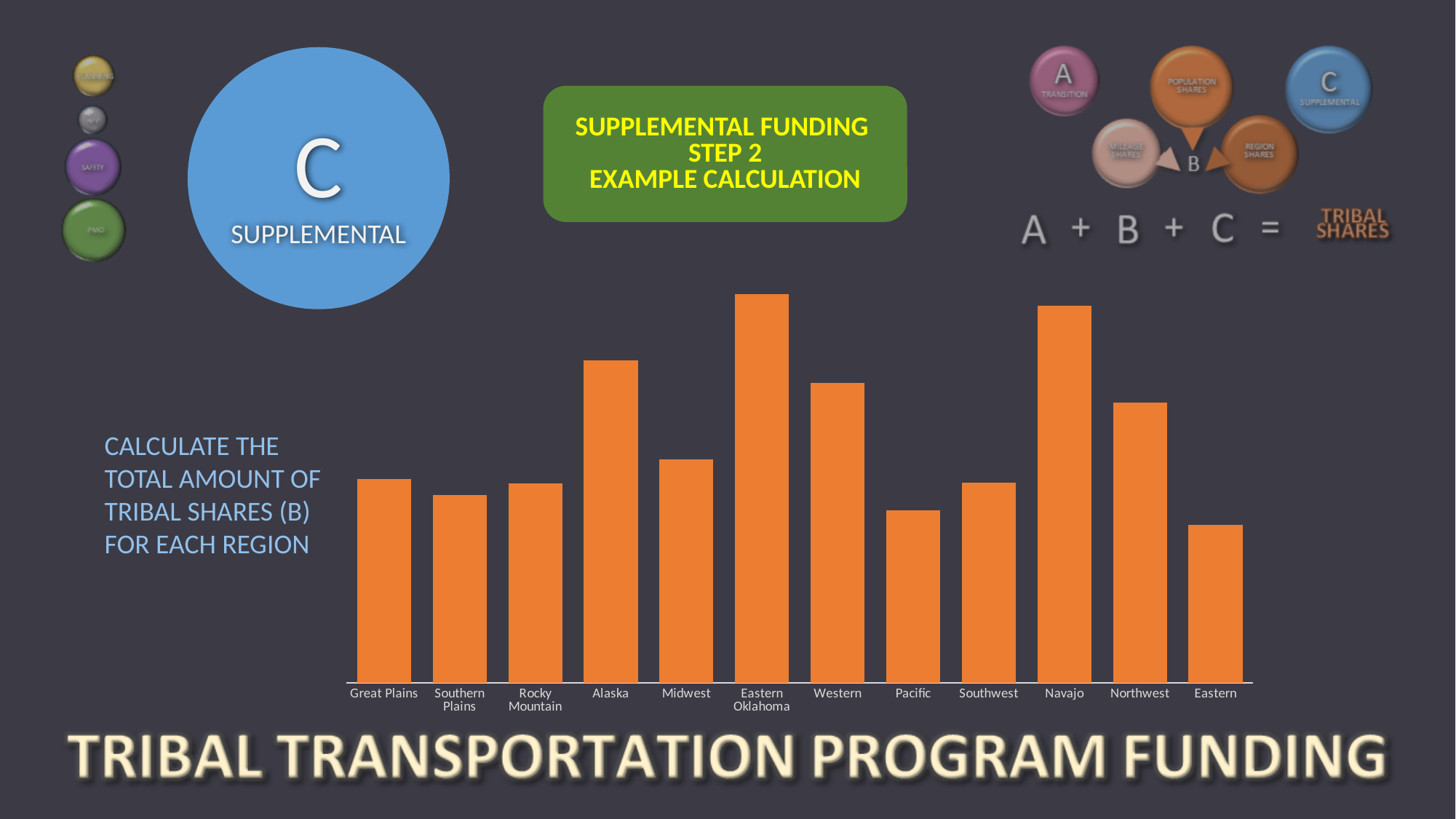
What colour are the bars in the chart? orange Which bar is taller, Eastern Oklahoma or Western? Eastern Oklahoma Which bar is taller, Alaska or Midwest? Alaska Which bar is taller, Western or Northwest? Western What kind of chart is shown on the slide? bar chart Which region has the tallest bar in the chart? Eastern Oklahoma Which region has the shortest bar in the chart? Eastern How many regions are shown on the x axis of the bar chart? 12 What is the label of the first category on the left of the x axis? Great Plains